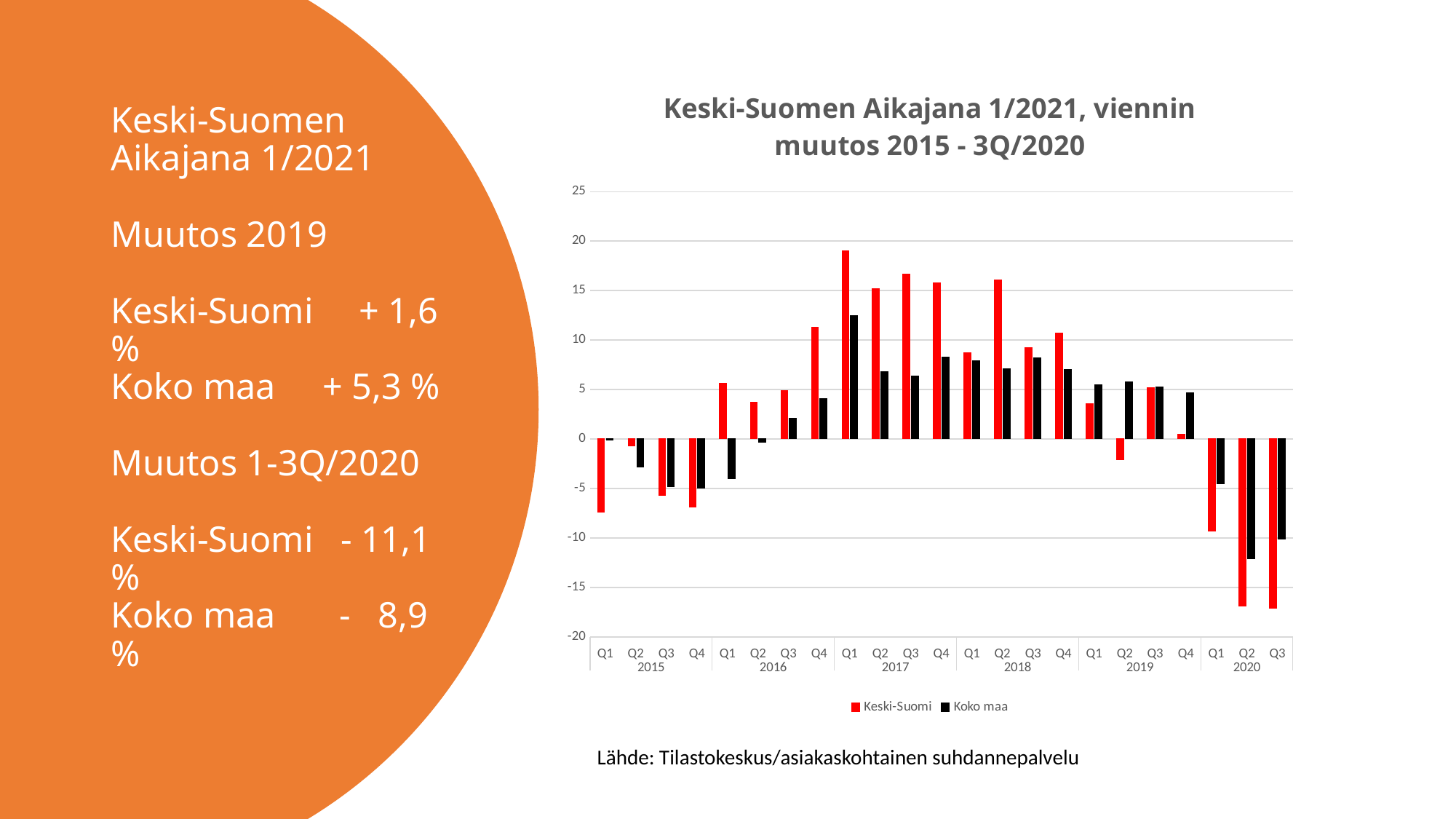
How many quarters are plotted along the x axis of the chart? 23 Is the Koko maa value for Q3 2020 greater or less than -5? less Is the Keski-Suomi value for Q2 2020 greater or less than -15? less Is the Keski-Suomi value for Q1 2017 greater or less than 15? greater In which quarter does the Koko maa series reach its highest value? Q1 2017 How many series does the chart legend list? 2 In Q4 2016, which series has the larger value, Keski-Suomi or Koko maa? Keski-Suomi What kind of chart is shown on the slide? bar chart Which two series are listed in the chart legend? Keski-Suomi and Koko maa In which quarter does the Koko maa series reach its lowest value? Q2 2020 In which quarter does the Keski-Suomi series reach its highest value? Q1 2017 In Q2 2019, which series has the larger value, Keski-Suomi or Koko maa? Koko maa